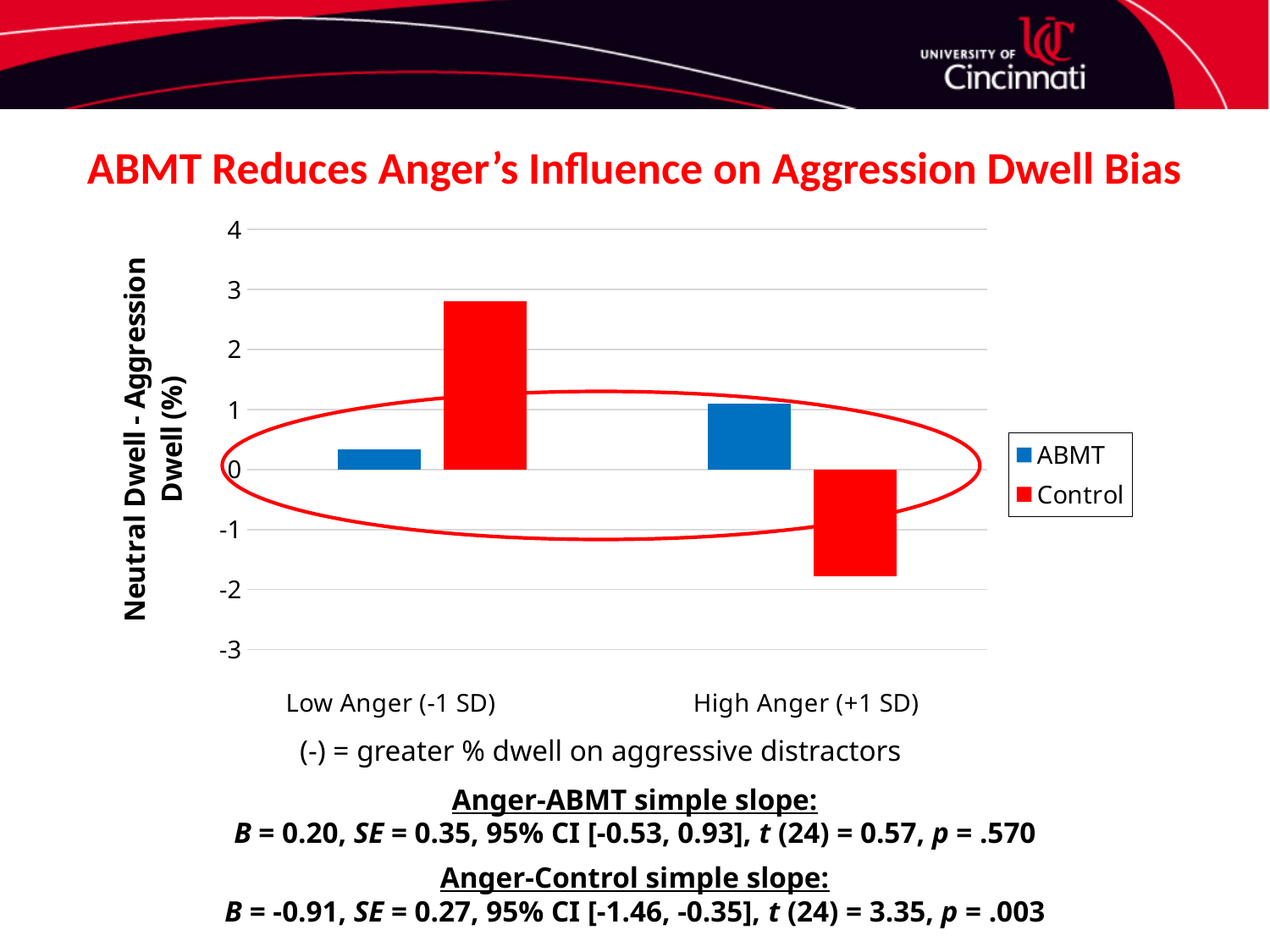
For High Anger (+1 SD), which series has the larger value, ABMT or Control? ABMT What kind of chart is shown on the slide? bar chart Does the Control series rise or fall from Low Anger (-1 SD) to High Anger (+1 SD)? fall How many series does the chart legend list? 2 Is the ABMT value for Low Anger (-1 SD) greater or less than 1? less Is the Control value for High Anger (+1 SD) greater or less than -1? less Is the ABMT value for High Anger (+1 SD) greater or less than 0? greater Which series and category has the lowest bar in the chart? Control at High Anger (+1 SD) For Low Anger (-1 SD), which series has the larger value, ABMT or Control? Control How many categories are shown on the x axis of the chart? 2 Which series and category has the highest bar in the chart? Control at Low Anger (-1 SD)